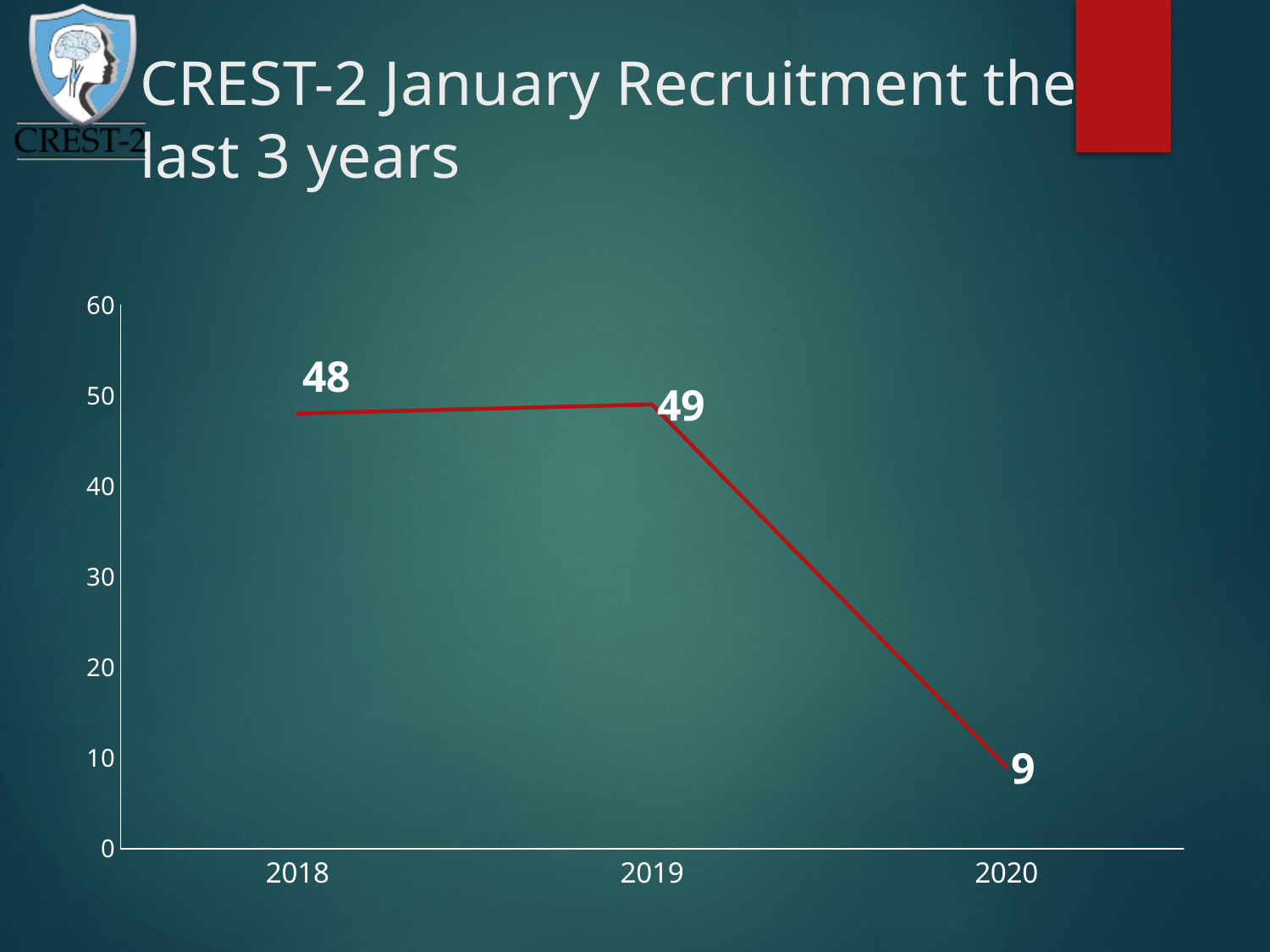
Which is larger, the value for 2018 or the value for 2020? 2018 What is the value for 2020? 9 Which year has the lowest value? 2020 What is the value for 2019? 49 What is the difference between the values for 2019 and 2020? 40 Is the value for 2020 greater or less than 10? less What kind of chart is shown on the slide? line chart What is the value for 2018? 48 Does the value rise or fall from 2019 to 2020? fall How many years are plotted on the chart? 3 What is the difference between the values for 2019 and 2018? 1 Which year has the highest value? 2019